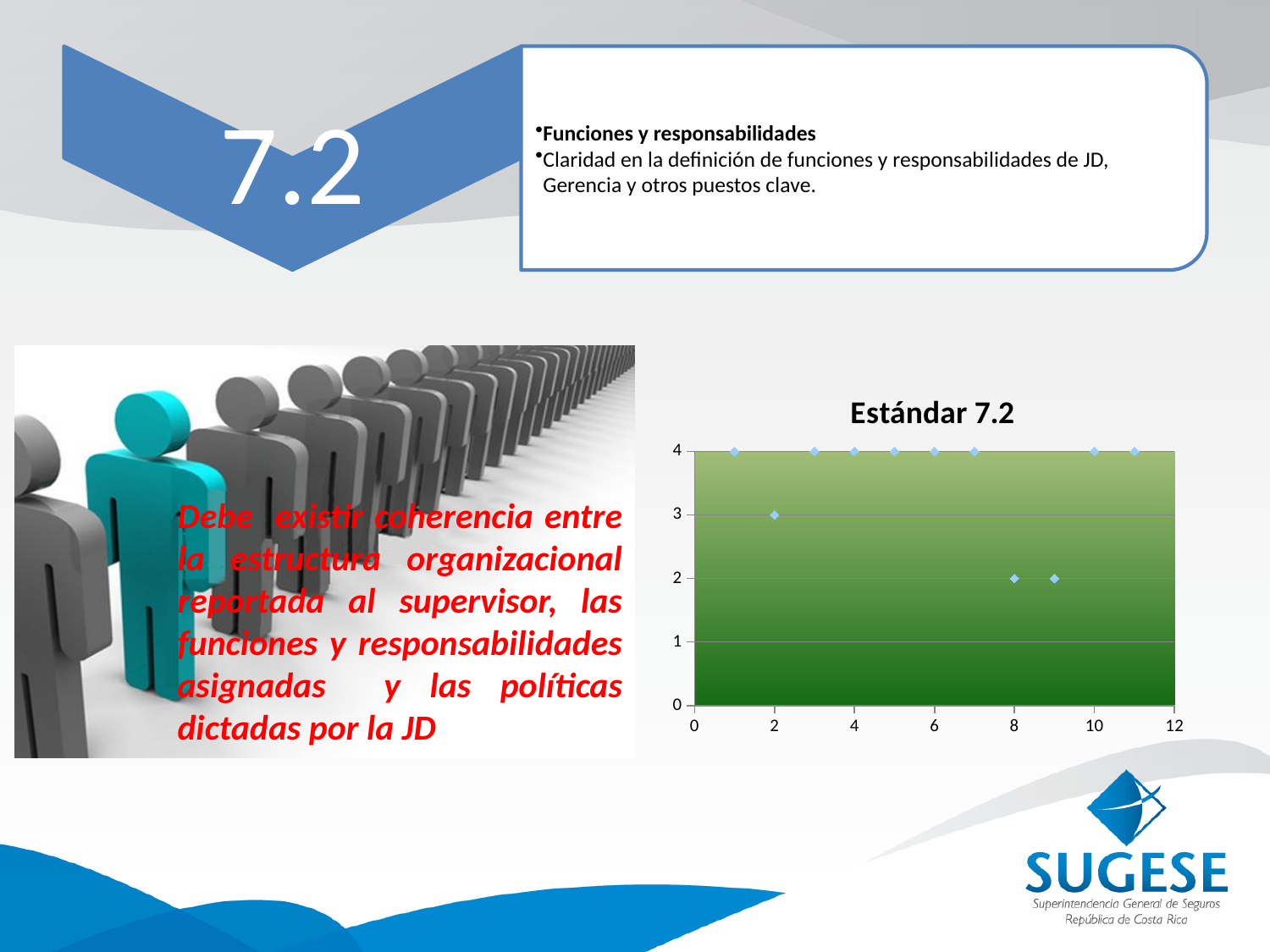
What kind of chart is shown under the title "Estándar 7.2"? Scatter chart In the "Estándar 7.2" chart, what is the lowest y value plotted? 2 How many data points are plotted in the "Estándar 7.2" chart? 11 In the "Estándar 7.2" chart, what is the highest y value plotted? 4 In the "Estándar 7.2" chart, what is the y value of the point at x = 8? 2 In the "Estándar 7.2" chart, which point has the larger y value, the one at x = 2 or the one at x = 8? x = 2 In the "Estándar 7.2" chart, what is the y value of the point at x = 2? 3 In the "Estándar 7.2" chart, what is the y value of the point at x = 9? 2 In the "Estándar 7.2" chart, what is the y value of the point at x = 1? 4 What is the title of the chart on the slide? Estándar 7.2 In the "Estándar 7.2" chart, is the y value of the point at x = 8 greater or less than 3? less In the "Estándar 7.2" chart, what is the difference between the y value at x = 2 and the y value at x = 8? 1